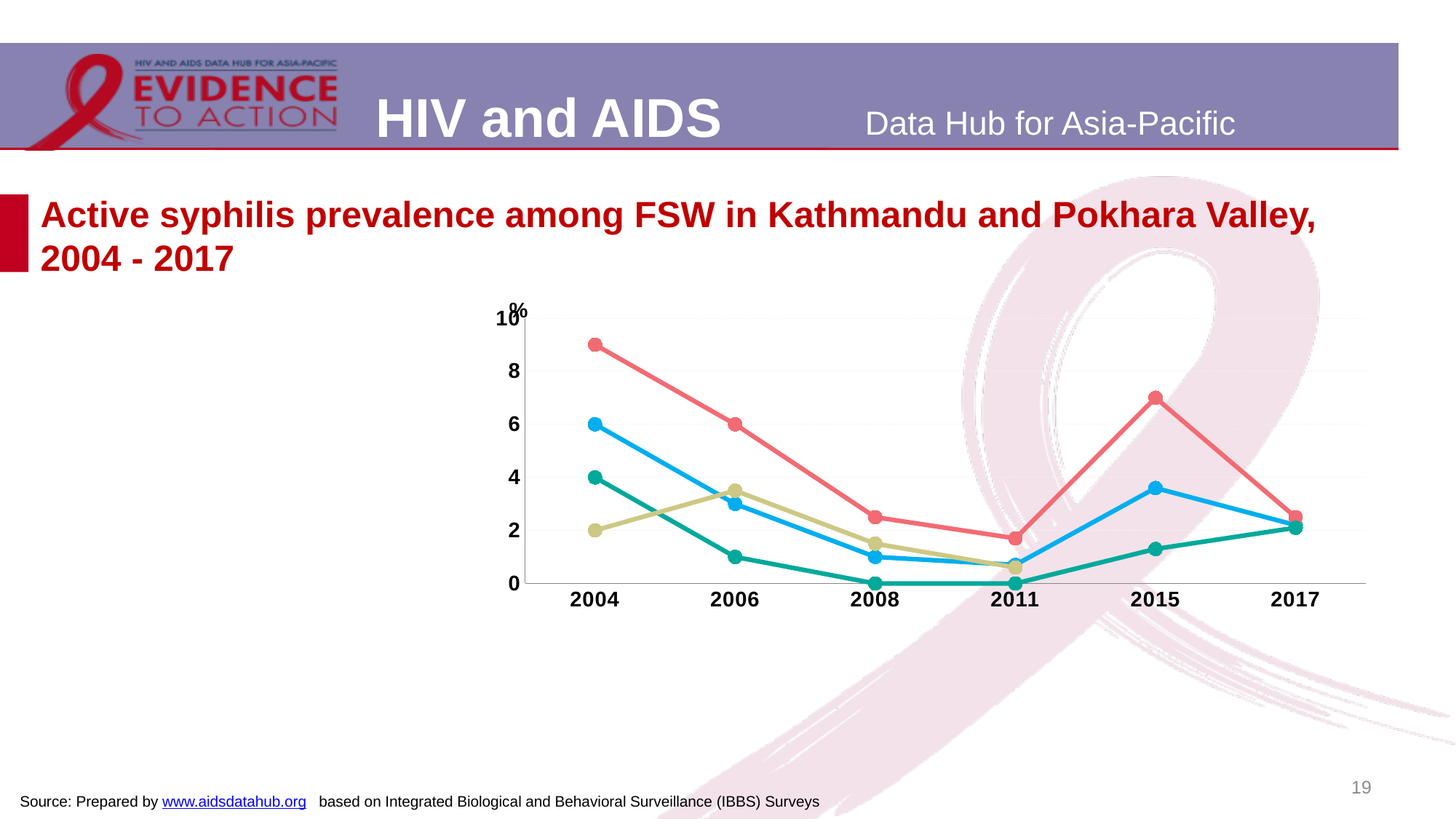
What kind of chart is shown on the slide? line chart Is the value of the red line in 2015 greater or less than 6? greater In 2004, which is larger: the red line or the blue line? red line What is the value of the green line in 2004? 4 In which year does the red line reach its highest value? 2004 Does the red line rise or fall from 2004 to 2011? fall What is the value of the yellow line in 2004? 2 What is the value of the green line in 2008? 0 How many years are plotted along the x axis? 6 Is the value of the red line in 2004 greater or less than 8? greater What is the value of the blue line in 2004? 6 What is the title of the chart on the slide? Active syphilis prevalence among FSW in Kathmandu and Pokhara Valley, 2004 - 2017